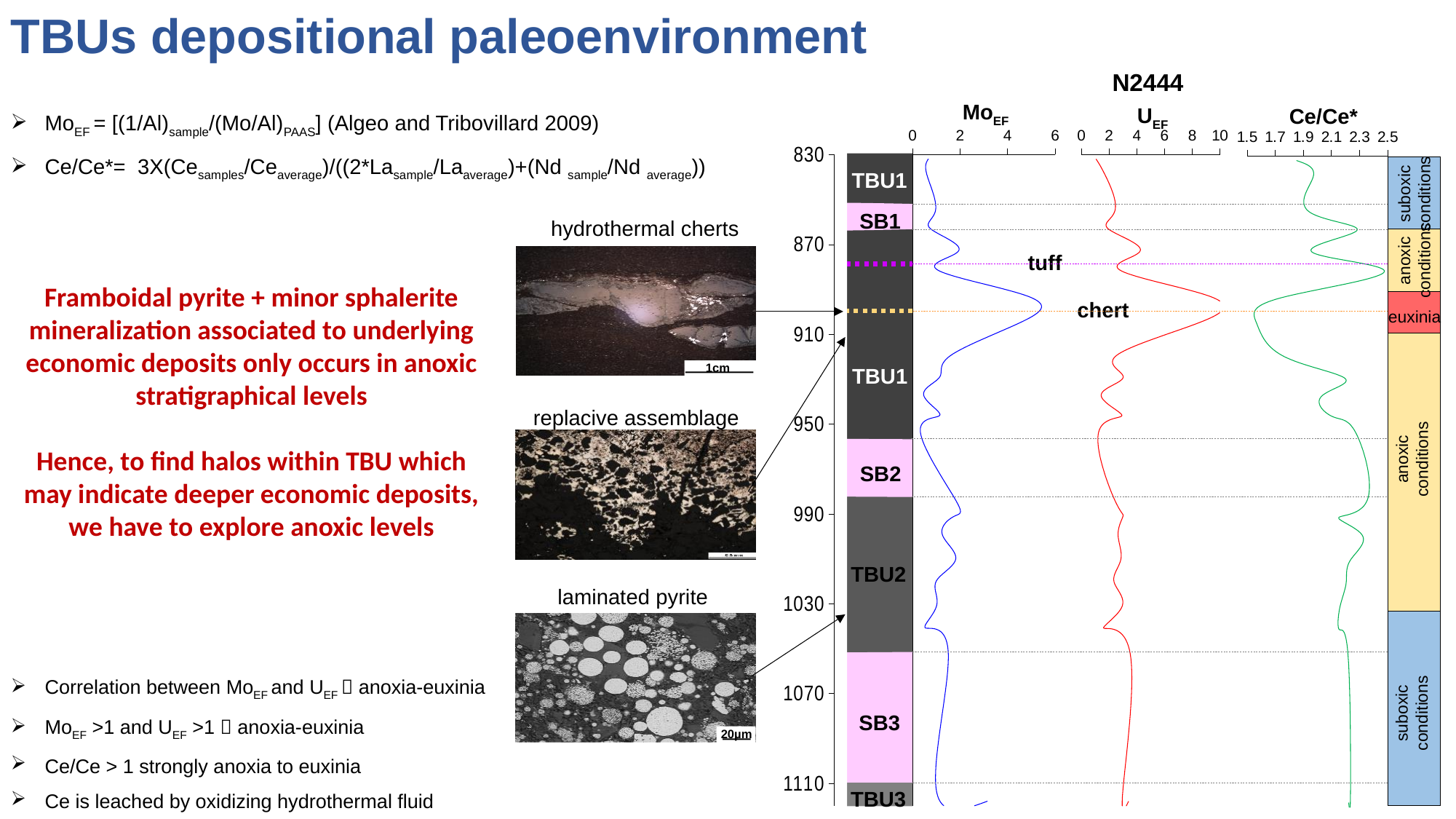
How many depth tick labels are shown on the vertical axis of the N2444 log? 8 What kind of chart is the N2444 log on the right of the slide? line chart What colour is the MoEF curve in the N2444 log? blue In the N2444 log, is the Ce/Ce* value at the chert level greater or less than 1.7? less In the N2444 log, is the MoEF value at the chert level greater or less than 4? greater Which stratigraphic unit is shown between depths 950 and 990 in the N2444 log? SB2 In the N2444 log, is the UEF value at the chert level greater or less than 8? greater Which redox condition label is assigned to the chert level in the N2444 log? euxinia How many geochemical curves are plotted in the N2444 log? 3 What is the title printed above the geochemical log? N2444